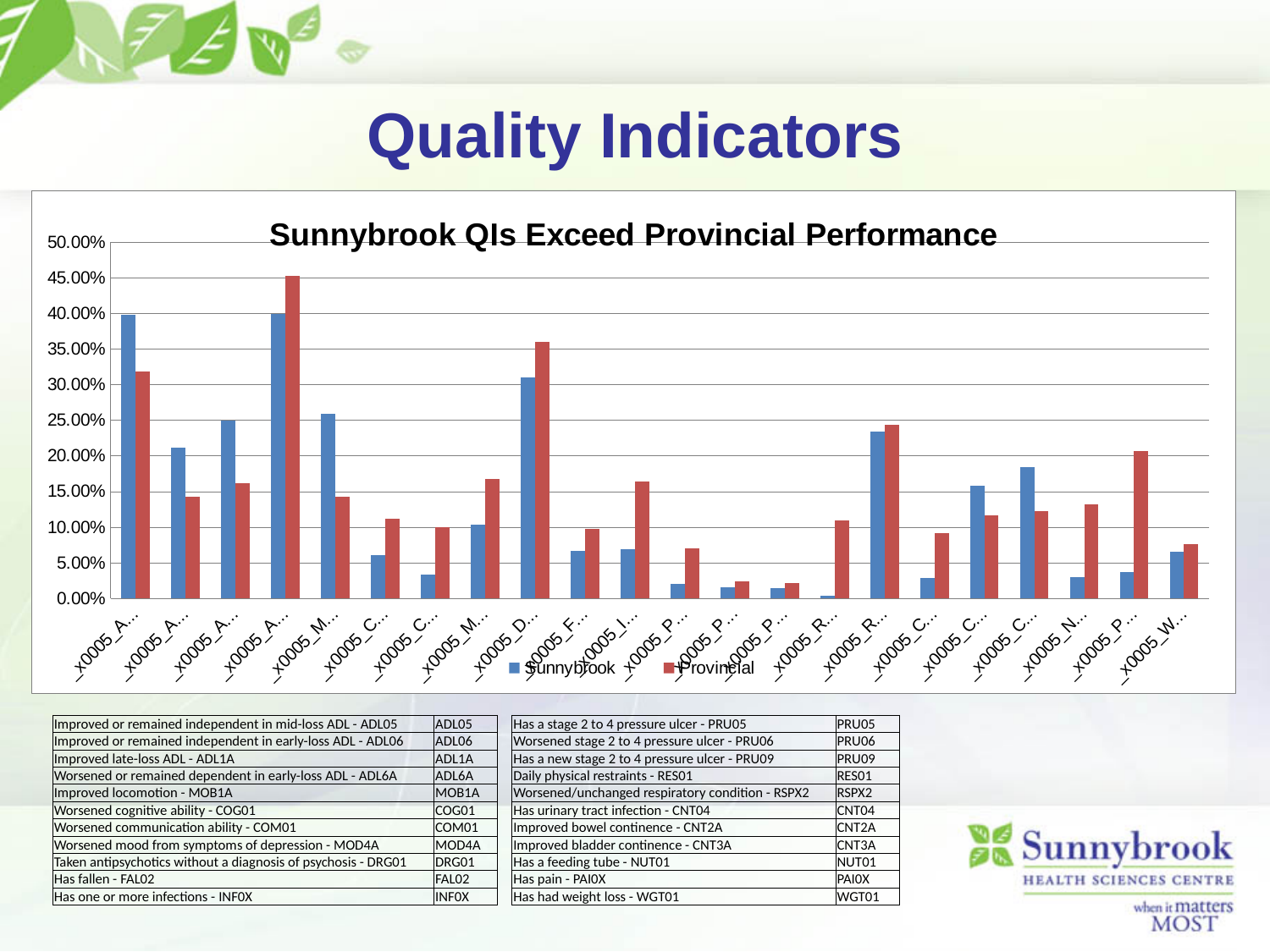
Is the Sunnybrook value for the first category on the x axis greater or less than 35.00%? greater Which series contains the tallest bar in the chart? Provincial Is the Provincial value for the second category on the x axis greater or less than 20.00%? less For the first category on the x axis, which series has the larger value, Sunnybrook or Provincial? Sunnybrook What are the two series named in the chart legend? Sunnybrook and Provincial Is the Sunnybrook value for the last category on the x axis greater or less than 10.00%? less What is the title of the chart? Sunnybrook QIs Exceed Provincial Performance What kind of chart is shown on the slide? bar chart How many series does the chart legend list? 2 For the fourth category on the x axis, which series has the larger value, Sunnybrook or Provincial? Provincial How many categories (pairs of bars) are plotted along the x axis? 22